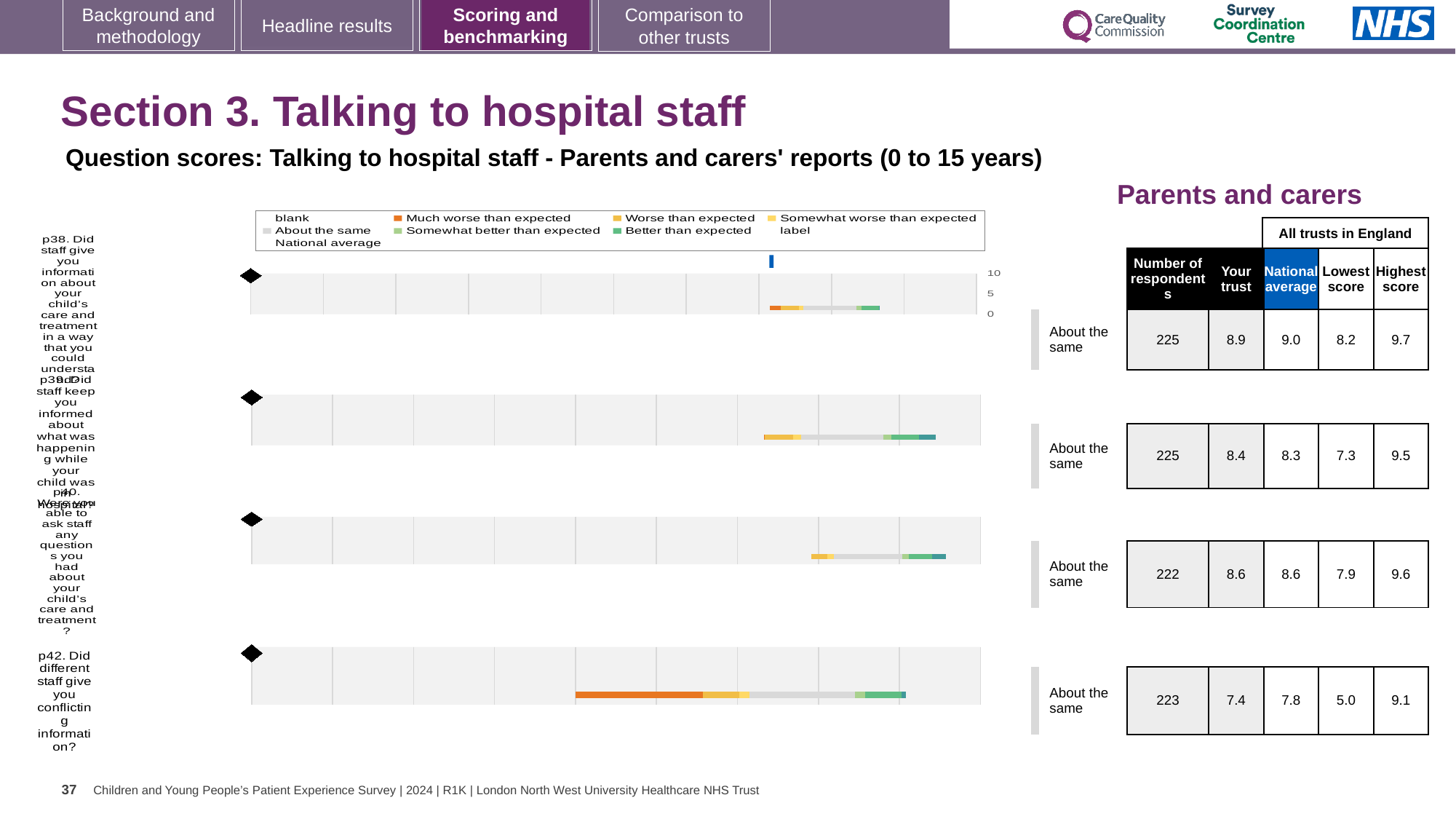
For p38, which is larger: the 'Your trust' score or the national average? National average What is the 'Your trust' score for p38 (Did staff give you information about your child's care and treatment in a way that you could understand)? 8.9 How many respondents answered p40 (Were you able to ask staff any questions you had about your child's care and treatment)? 222 Which question has the highest 'Your trust' score? p38 What kind of chart is used to show the question scores on this slide? bar chart What is the national average score for p42 (Did different staff give you conflicting information)? 7.8 Which question has the lowest 'Your trust' score? p42 What is the highest score across all trusts in England for p40? 9.6 What is the difference between the highest score and the lowest score for p42? 4.1 What benchmark category is shown for p39 (Did staff keep you informed about what was happening while your child was in hospital)? About the same What is the lowest score across all trusts in England for p42? 5.0 How many questions (bars) are plotted in the chart? 4